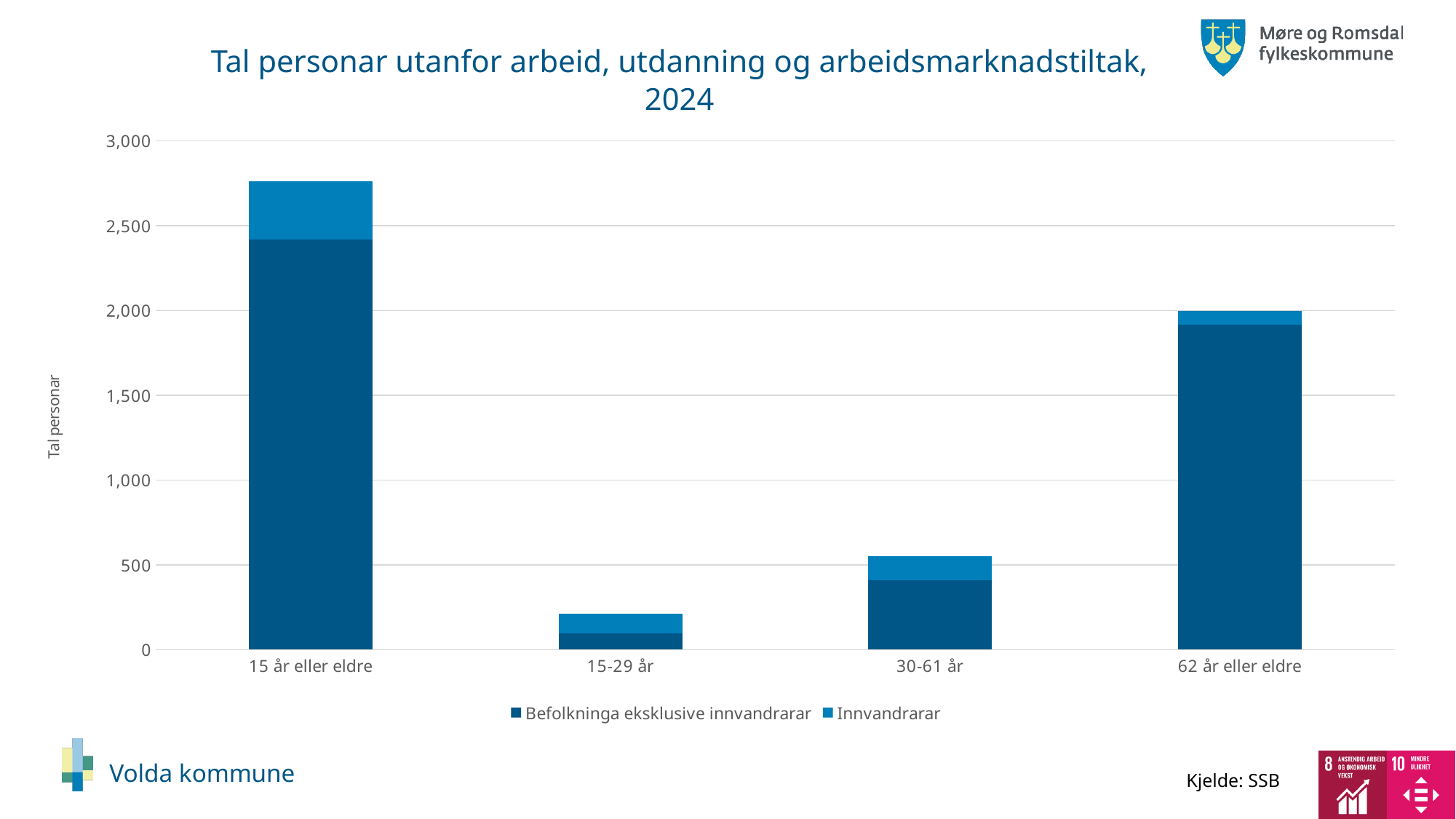
Which stacked bar is taller, 30-61 år or 15-29 år? 30-61 år Which stacked bar is taller, 62 år eller eldre or 30-61 år? 62 år eller eldre Is the total stacked bar for 15 år eller eldre greater or less than 2,500? greater Is the Befolkninga eksklusive innvandrarar value for 30-61 år greater or less than 500? less What is the label on the vertical axis of the chart? Tal personar Is the total stacked bar for 15-29 år greater or less than 500? less Which category has the tallest stacked bar? 15 år eller eldre Which category has the shortest stacked bar? 15-29 år How many series does the legend list? 2 What kind of chart is shown on the slide? bar chart How many categories are shown on the x axis of the chart? 4